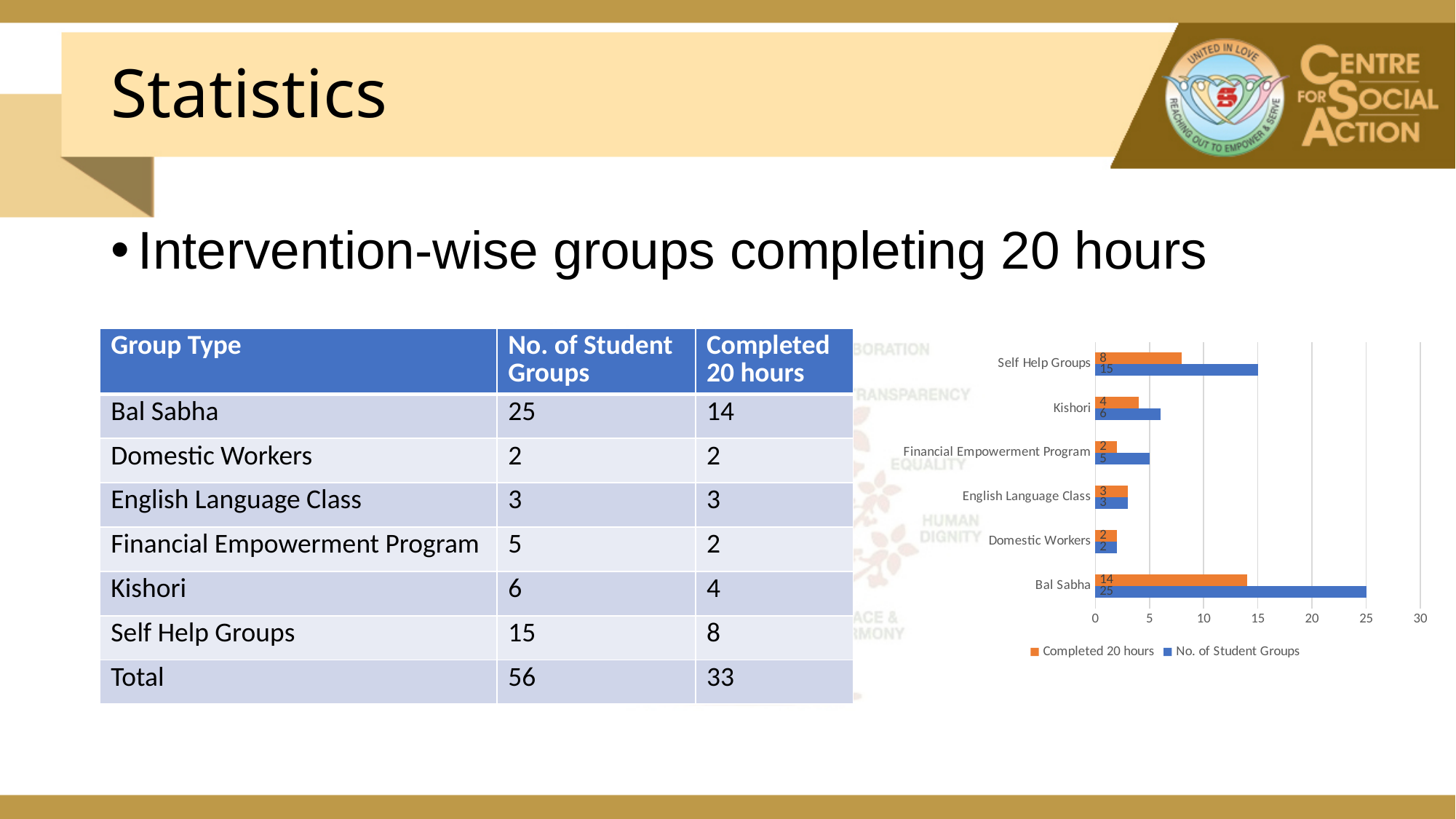
What is the difference between No. of Student Groups and Completed 20 hours for Bal Sabha on the chart? 11 On the chart, which is larger for Financial Empowerment Program: No. of Student Groups or Completed 20 hours? No. of Student Groups What kind of chart is shown on the slide? bar chart Which group type has the highest No. of Student Groups on the chart? Bal Sabha What is the value of No. of Student Groups for Bal Sabha on the chart? 25 How many series does the chart legend list? 2 Which colour represents the Completed 20 hours series on the chart? orange How many group types are plotted on the chart? 6 What is the value of Completed 20 hours for Self Help Groups on the chart? 8 What is the value of Completed 20 hours for Kishori on the chart? 4 Is the value of No. of Student Groups for Self Help Groups greater or less than 10 on the chart? greater Which group type has the lowest No. of Student Groups on the chart? Domestic Workers